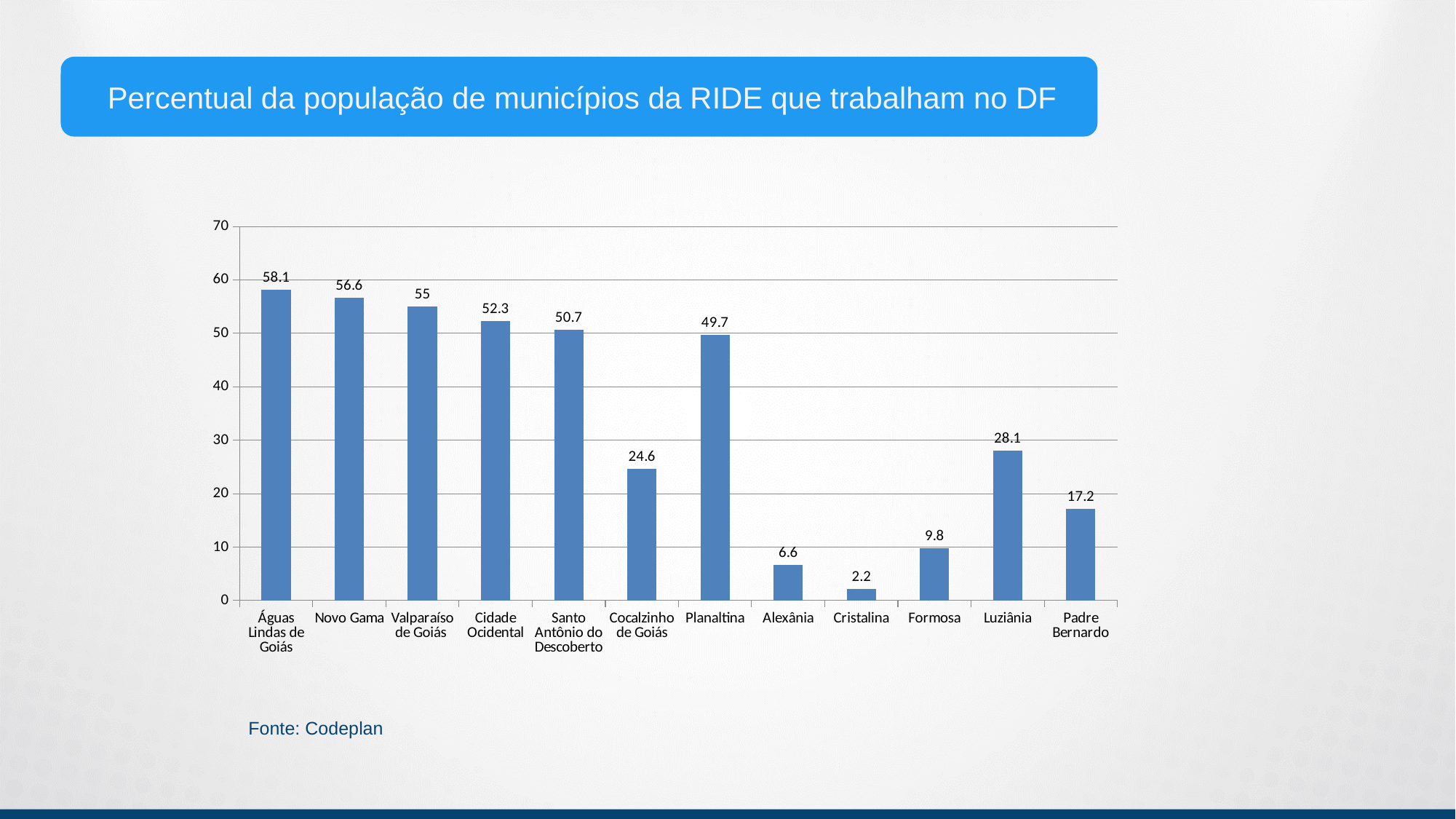
What is the difference between the values for Luziânia and Formosa? 18.3 Which municipality has the lowest value? Cristalina Which is larger, the value for Santo Antônio do Descoberto or the value for Alexânia? Santo Antônio do Descoberto What is the value for Cocalzinho de Goiás? 24.6 Which municipality has the highest value? Águas Lindas de Goiás What is the source cited below the chart? Codeplan What is the difference between the values for Águas Lindas de Goiás and Planaltina? 8.4 What is the value for Novo Gama? 56.6 What is the value for Padre Bernardo? 17.2 How many municipalities are shown on the chart? 12 What kind of chart is shown on the slide? Bar chart Is the value for Cidade Ocidental greater or less than 50? greater